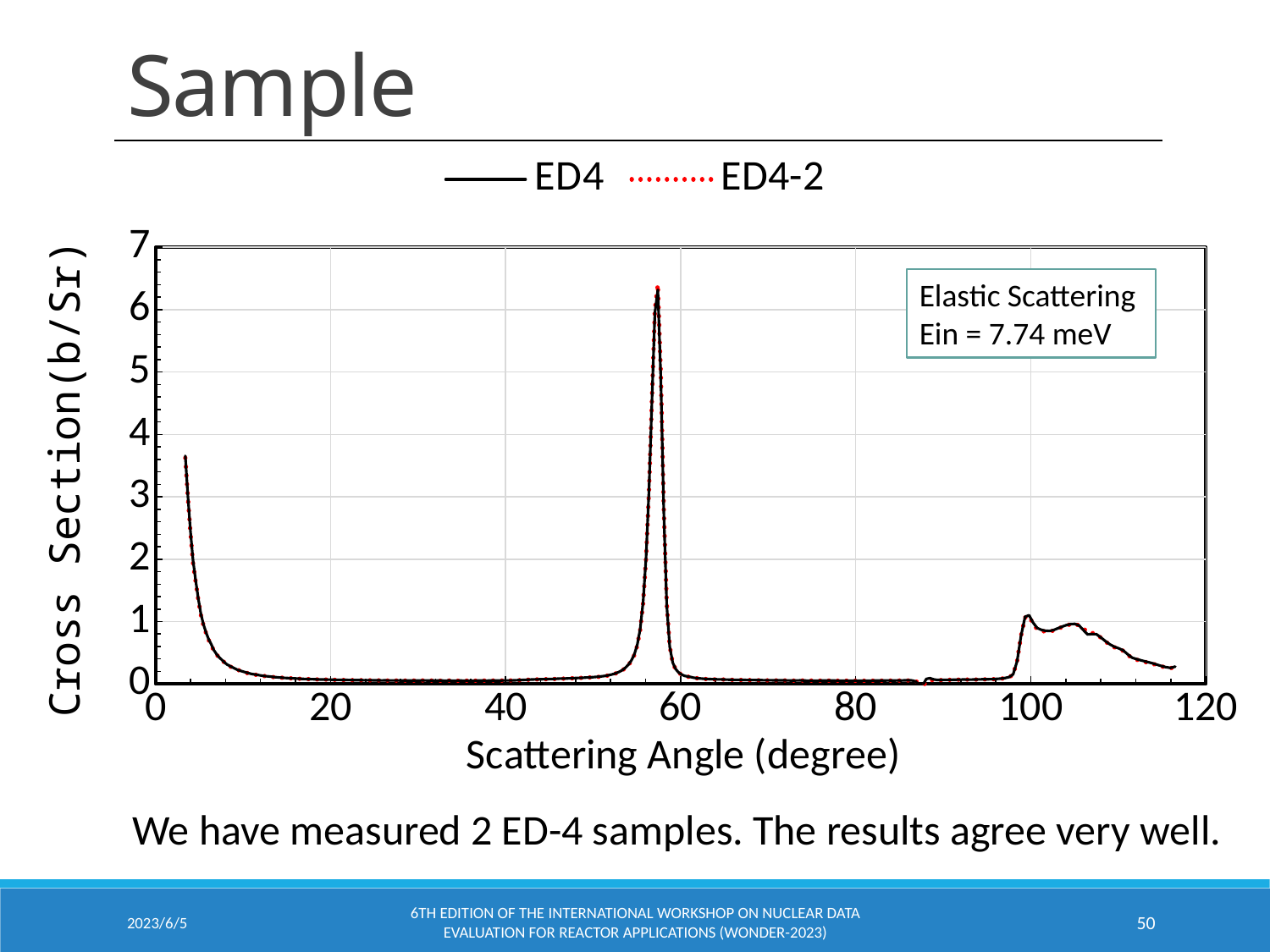
How many series does the legend list? 2 What is the maximum value shown on the y axis? 7 Is the peak value of the ED4 series near a scattering angle of 58 degrees greater or less than 6? greater Does the ED4 series rise or fall between scattering angles of 5 and 20 degrees? fall Is the value of the ED4 series at a scattering angle of 100 degrees greater or less than 2? less What kind of chart is shown on the slide? line chart Which is larger for the ED4 series: the value at a scattering angle of 58 degrees or the value at 100 degrees? 58 degrees What are the names of the two series in the legend? ED4 and ED4-2 Is the value of the ED4 series at its lowest plotted scattering angle (about 3 degrees) greater or less than 3? greater What is the label of the x axis? Scattering Angle (degree) Does the ED4 series rise or fall between scattering angles of 105 and 115 degrees? fall